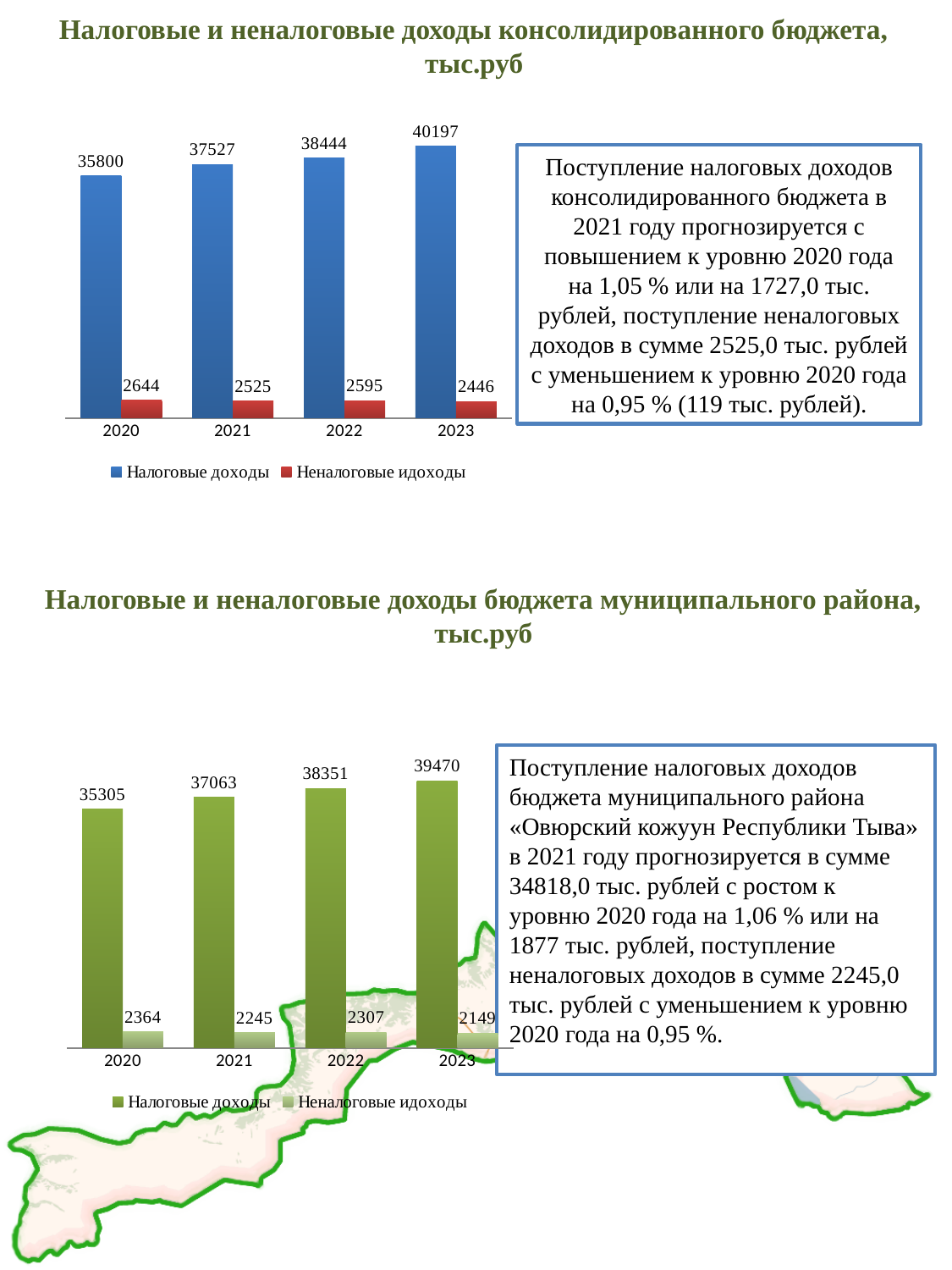
In the bottom chart (municipal district budget), which year has the highest non-tax revenues? 2020 In the top chart (consolidated budget), what is the difference between tax revenues in 2023 and 2020? 4397 In the top chart (consolidated budget), what is the value of non-tax revenues (Неналоговые доходы) for 2023? 2446 How many series does the legend of the bottom chart (municipal district budget) list? 2 What type of chart is the top chart (consolidated budget)? bar chart In the bottom chart (municipal district budget), what is the value of tax revenues for 2022? 38351 In the top chart (consolidated budget), which year has the highest tax revenues? 2023 In the top chart (consolidated budget), what is the value of tax revenues (Налоговые доходы) for 2021? 37527 In the bottom chart (municipal district budget), what is the value of non-tax revenues for 2020? 2364 In the bottom chart (municipal district budget), what is the difference between non-tax revenues in 2020 and 2021? 119 In the top chart (consolidated budget), do tax revenues rise or fall from 2020 to 2023? rise In the top chart (consolidated budget), which year has the lowest non-tax revenues? 2023